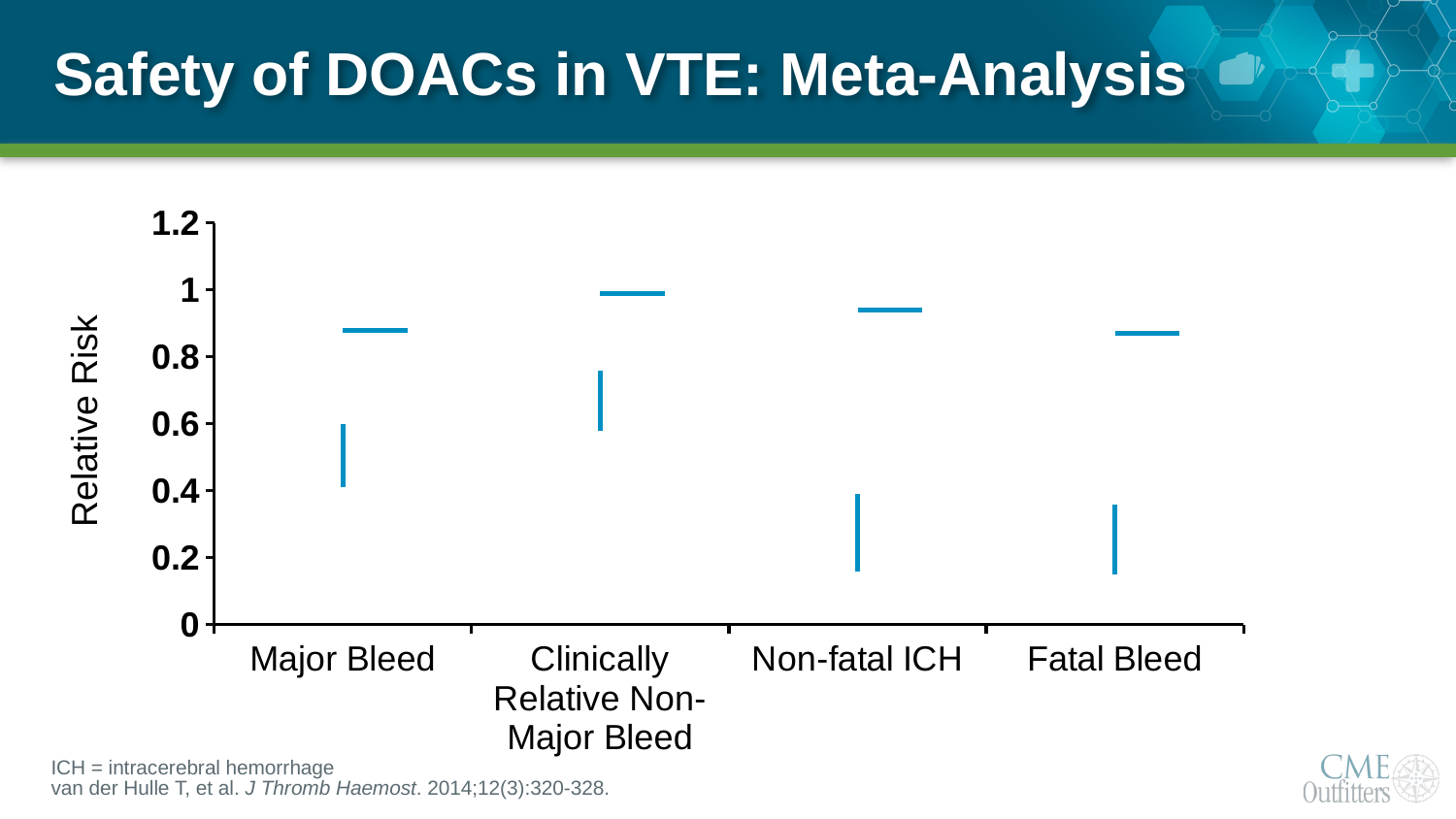
Is the horizontal marker for Major Bleed greater or less than 1? less Is the horizontal marker for Non-fatal ICH greater or less than 0.8? greater How many categories are shown on the x axis of the chart? 4 Is the horizontal marker for Fatal Bleed greater or less than 1? less Which category has the highest horizontal marker? Clinically Relative Non-Major Bleed What is the highest value shown on the y axis of the chart? 1.2 Which category's vertical line reaches the highest point? Clinically Relative Non-Major Bleed What is the label of the y axis of the chart? Relative Risk Which horizontal marker is higher, Non-fatal ICH or Major Bleed? Non-fatal ICH